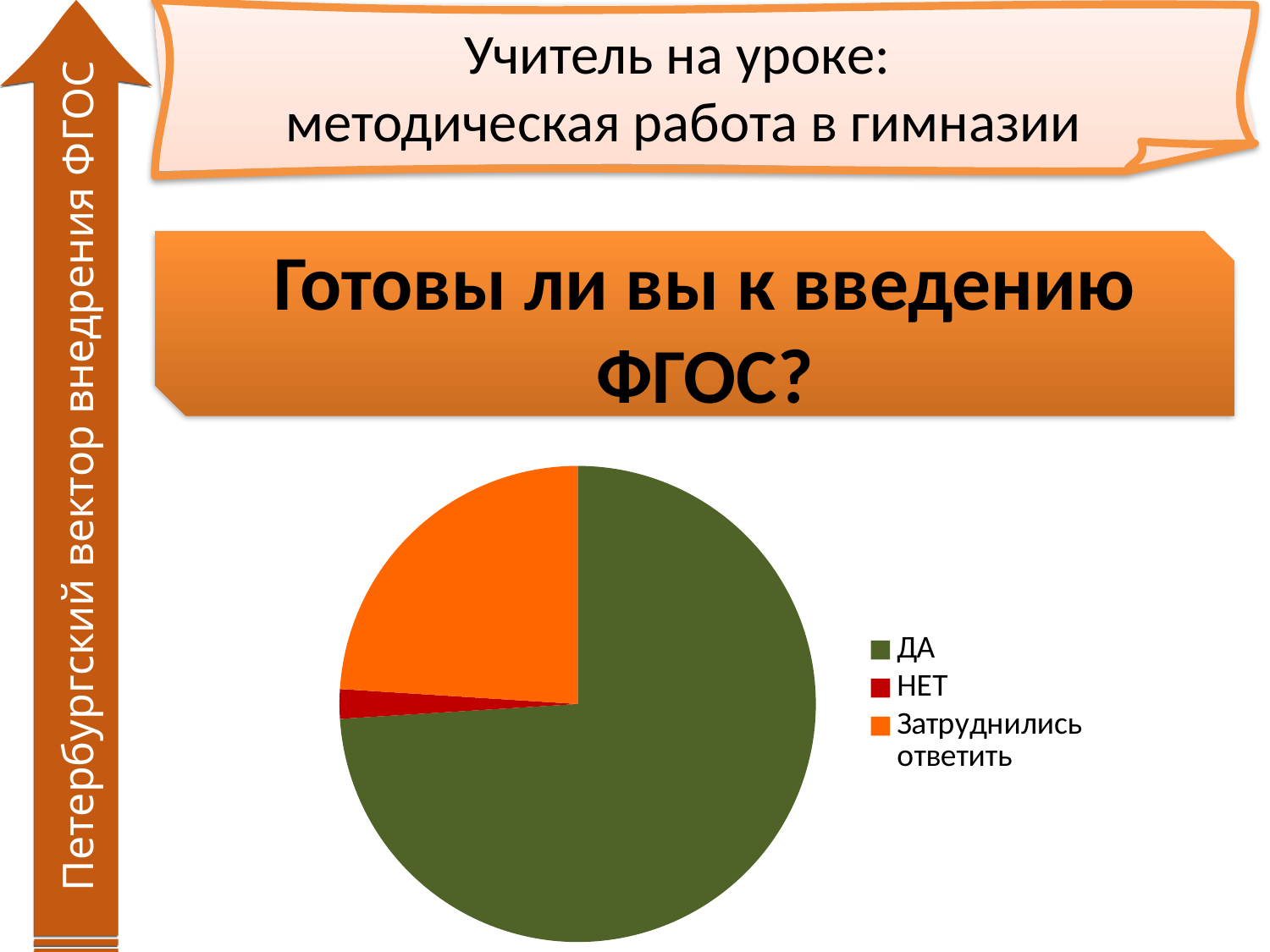
Does the ДА slice take up more or less than half of the pie chart? more Which slice is larger in the pie chart: НЕТ or Затруднились ответить? Затруднились ответить What colour is the ДА slice in the pie chart? green How many slices does the pie chart have? 3 Which category has the smallest slice in the pie chart? НЕТ How many entries does the legend of the pie chart list? 3 What kind of chart is shown on the slide? pie chart Which category has the largest slice in the pie chart? ДА What question does the pie chart on the slide answer, according to the orange banner above it? Готовы ли вы к введению ФГОС? Which slice is larger in the pie chart: ДА or Затруднились ответить? ДА